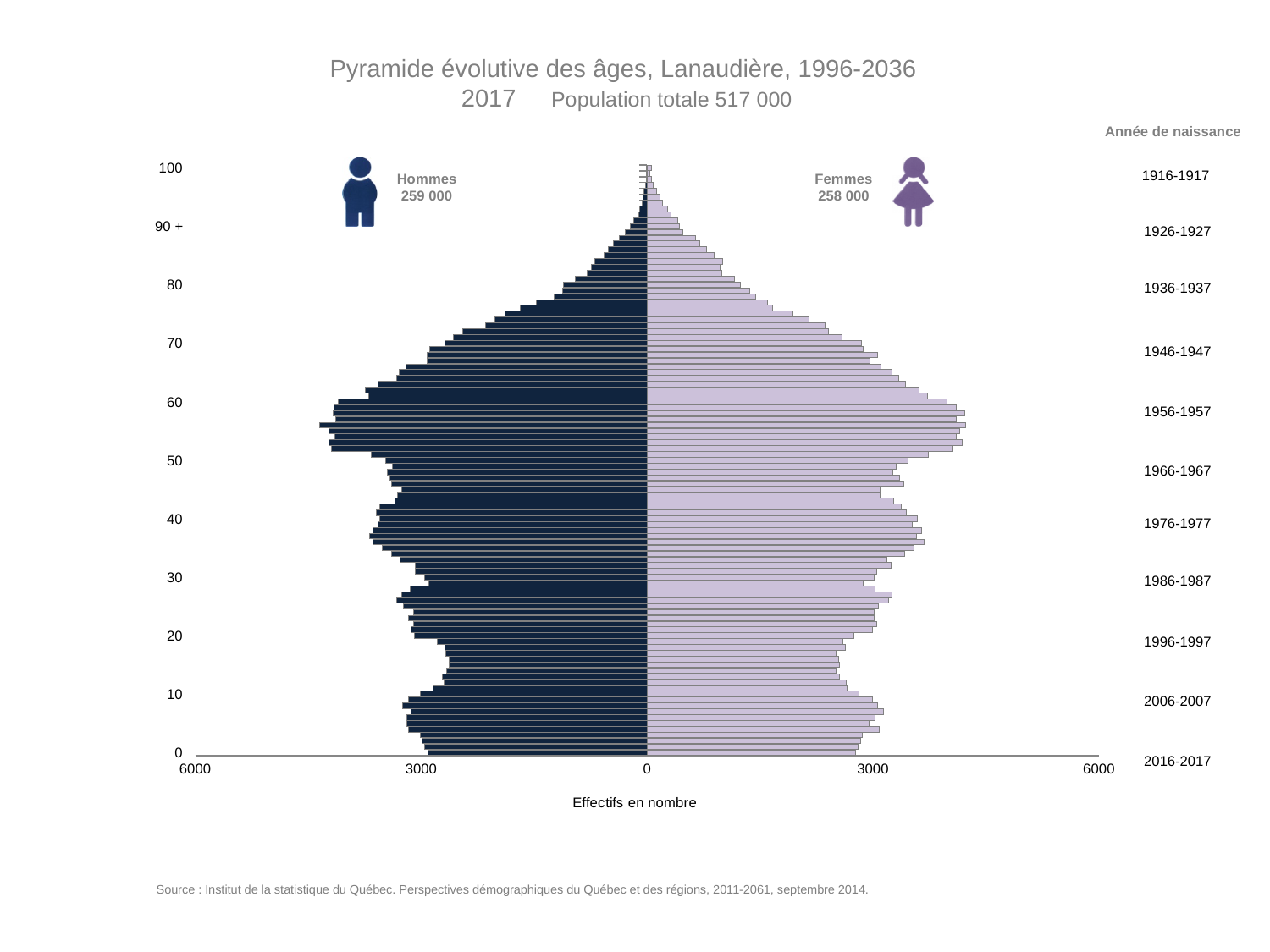
What is the difference between the number of Hommes and the number of Femmes? 1 000 Is the number of women aged around 15 greater or less than 3000? less What is the label of the horizontal axis? Effectifs en nombre What is the number of Femmes (women) shown on the chart? 258 000 Which group is larger, Hommes or Femmes? Hommes How many population groups (series) does the chart show? 2 What is the number of Hommes (men) shown on the chart? 259 000 Is the number of women aged around 80 greater or less than 3000? less From age 60 up to age 100, do the bar lengths rise or fall as age increases? fall What kind of chart is shown on the slide? Bar chart (population pyramid) Is the number of men aged around 57 greater or less than 3000? greater What is the total population shown on the slide for 2017? 517 000